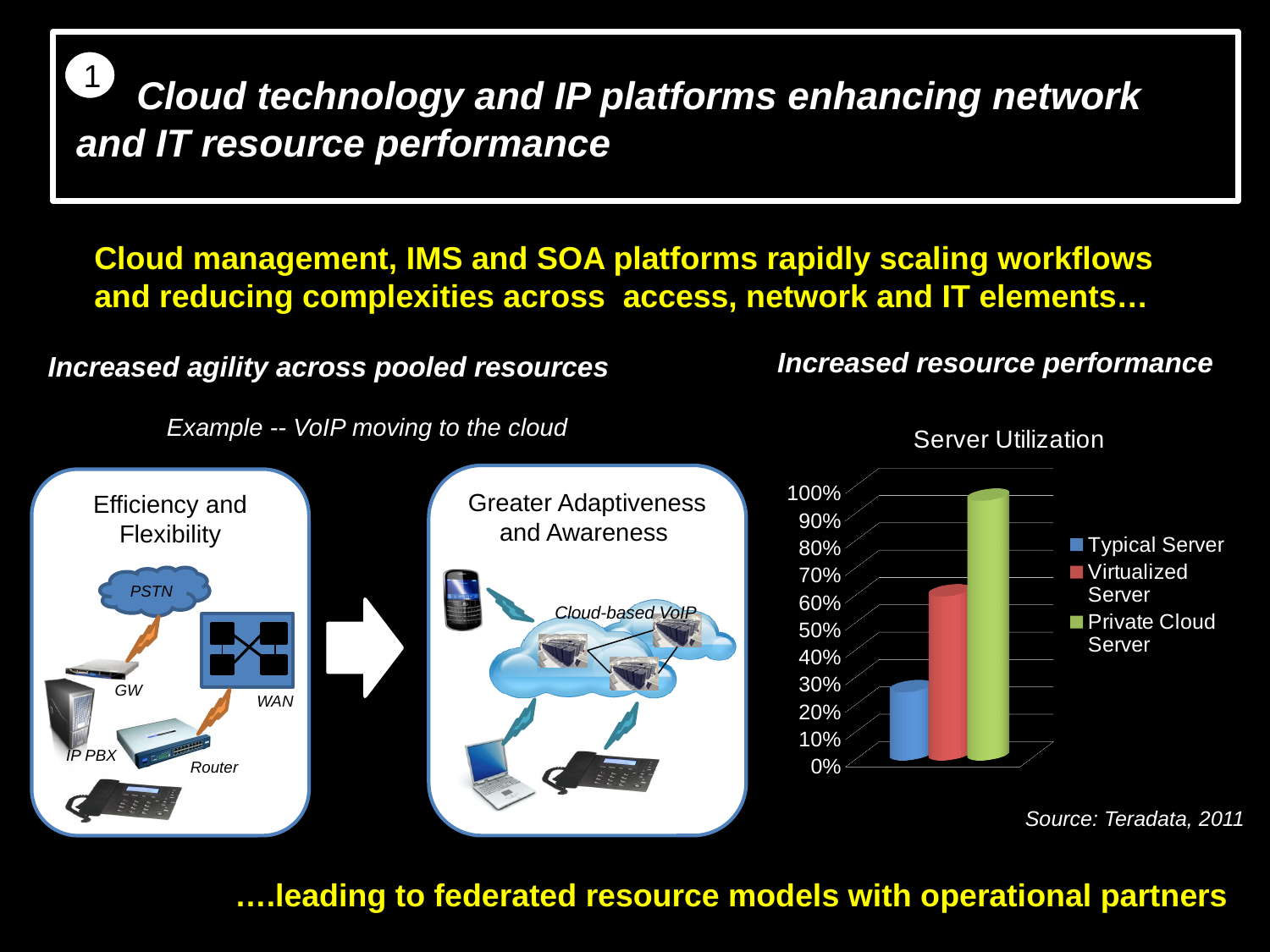
In the Server Utilization chart, is the value for Typical Server greater or less than 40%? less What is the title of the chart on the slide? Server Utilization How many bars are plotted in the Server Utilization chart? 3 What colour represents Typical Server in the Server Utilization chart? blue In the Server Utilization chart, which is larger: the value for Virtualized Server or the value for Typical Server? Virtualized Server In the Server Utilization chart, which server type has the highest utilization? Private Cloud Server How many series does the legend of the Server Utilization chart list? 3 In the Server Utilization chart, is the value for Typical Server greater or less than 20%? greater What kind of chart is the Server Utilization chart? bar chart In the Server Utilization chart, which server type has the lowest utilization? Typical Server In the Server Utilization chart, is the value for Virtualized Server greater or less than 50%? greater